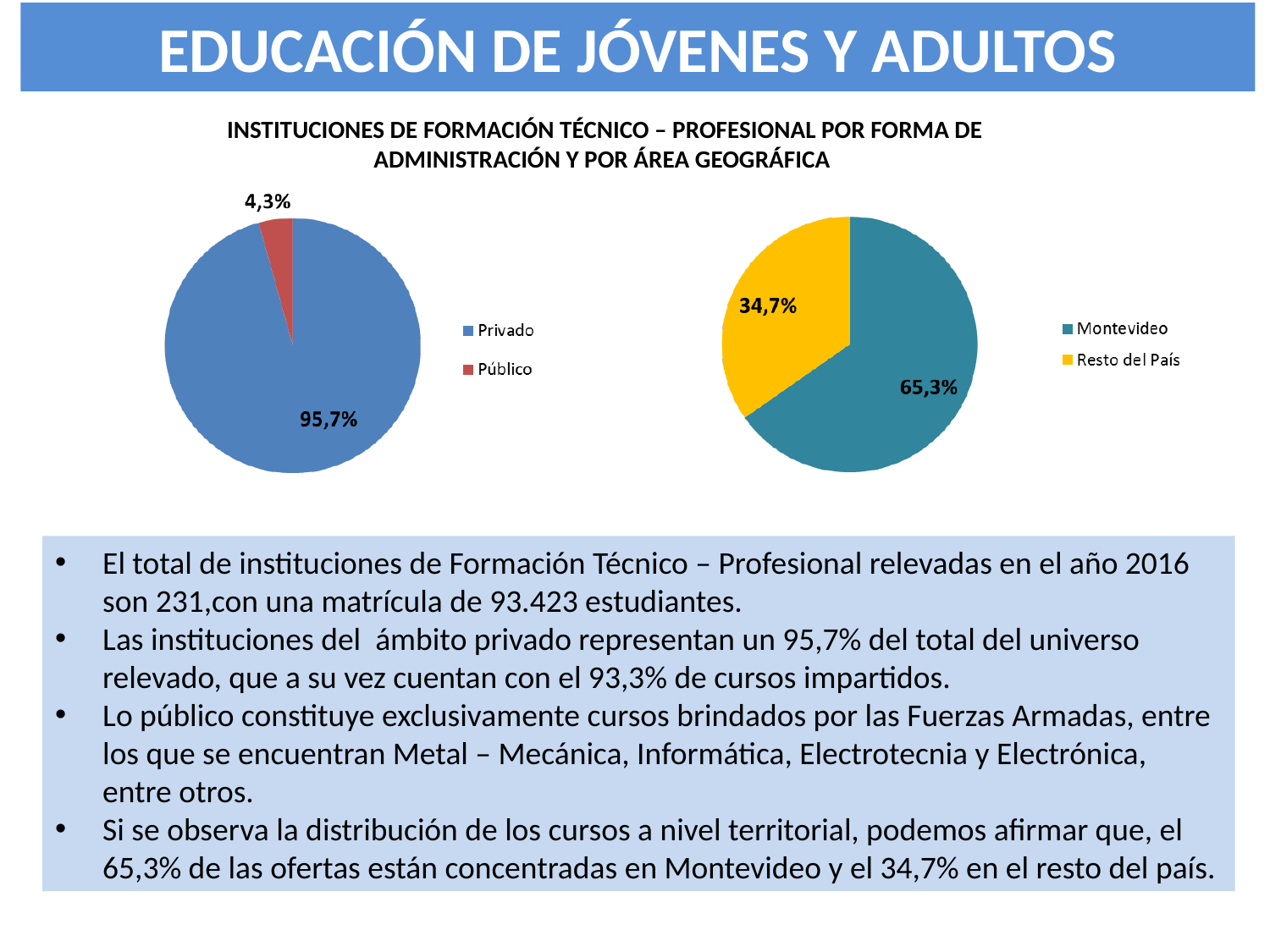
In the right pie chart, which is larger, Montevideo or Resto del País? Montevideo What kind of chart is the left chart on the slide? Pie chart In the left pie chart, which category has the largest share? Privado In the right pie chart, what is the difference between the Montevideo and Resto del País shares? 30,6% In the left pie chart, what colour is the Público slice? Red How many categories does the legend of the right pie chart list? 2 In the right pie chart (Montevideo/Resto del País), what is the value for Montevideo? 65,3% In the left pie chart, what is the difference between the Privado and Público shares? 91,4% In the left pie chart (Privado/Público), what is the value for Público? 4,3% In the left pie chart (Privado/Público), what is the value for Privado? 95,7% In the right pie chart (Montevideo/Resto del País), what is the value for Resto del País? 34,7% In the right pie chart, which category has the smallest share? Resto del País